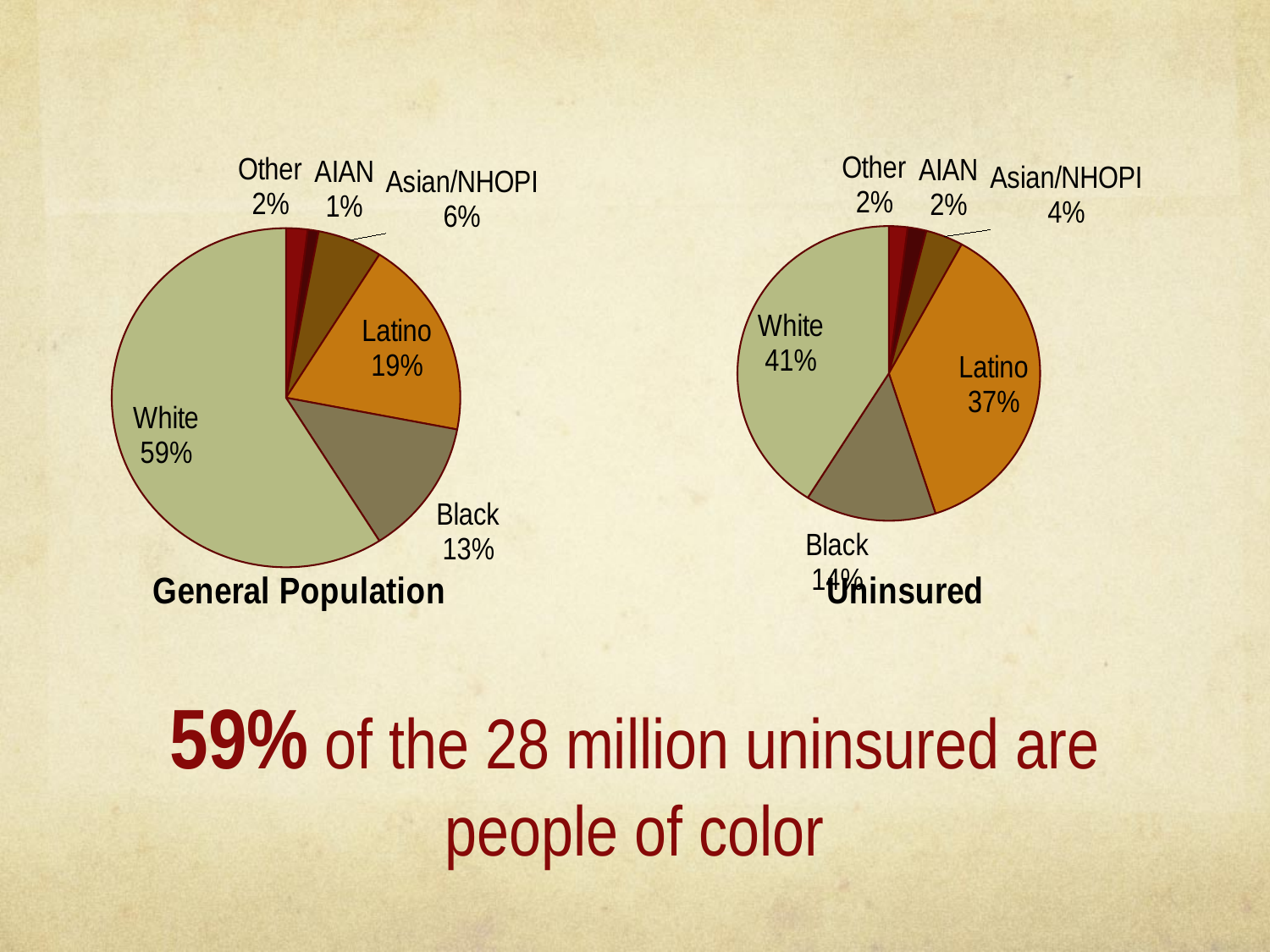
In the General Population pie chart, what share is Black? 13% How many slices does the General Population pie chart have? 6 Is the Latino share larger in the General Population chart or in the Uninsured chart? Uninsured What is the title of the pie chart on the left? General Population What type of chart is used for the Uninsured data? Pie chart In the General Population pie chart, which group has the smallest share? AIAN In the General Population pie chart, what share is White? 59% In the Uninsured pie chart, what share is Latino? 37% In the Uninsured pie chart, which group has the largest share? White What is the difference between the White share in the General Population chart and the White share in the Uninsured chart? 18 percentage points In the General Population pie chart, which group has the largest share? White In the Uninsured pie chart, what share is Asian/NHOPI? 4%